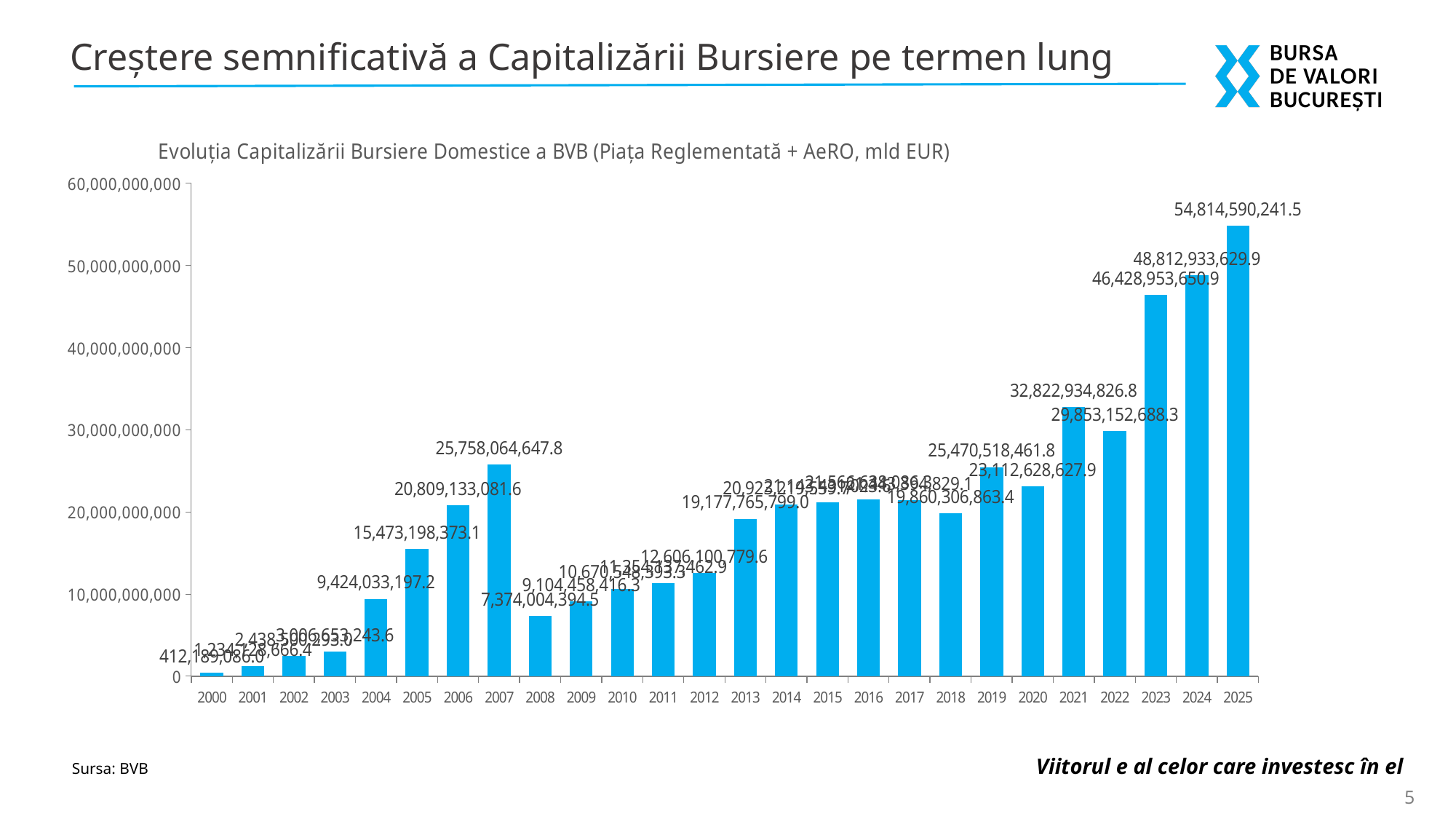
Which year has the lowest value? 2000 Is the value for 2003 greater or less than 10,000,000,000? less What is the value for 2007? 25,758,064,647.8 How many years are shown on the x axis? 26 What is the difference between the values for 2025 and 2024? 6,001,656,611.6 Which year has the highest value? 2025 Which is larger, the value for 2021 or the value for 2022? 2021 What type of chart is shown on the slide? Bar chart What is the value for 2021? 32,822,934,826.8 What is the value for 2008? 7,374,004,394.5 What is the value for 2025? 54,814,590,241.5 Do the values rise or fall from 2022 to 2025? rise